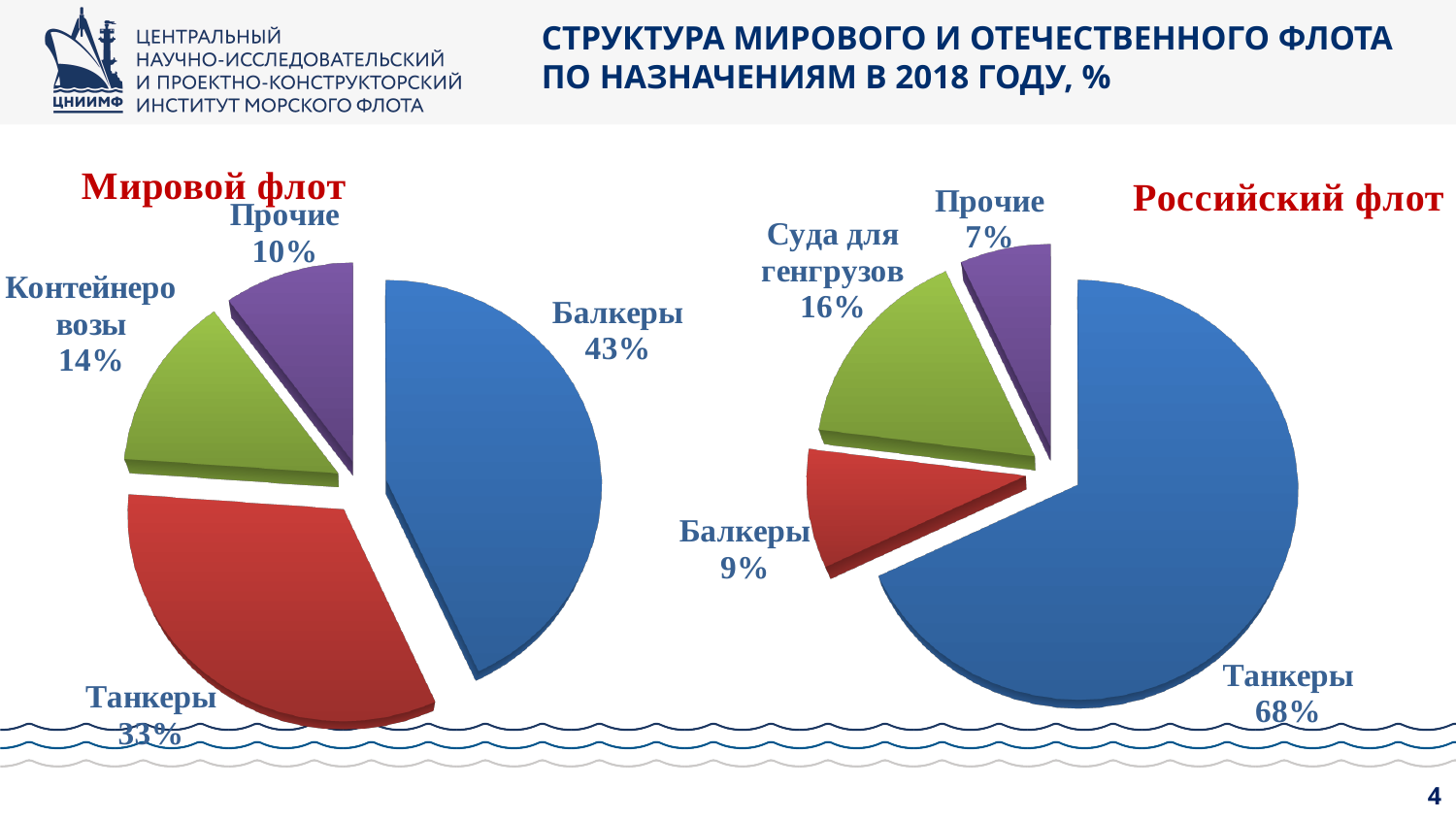
Which is larger: the share of Прочие in the 'Мировой флот' chart or the share of Прочие in the 'Российский флот' chart? Мировой флот In the 'Российский флот' pie chart, what share do Суда для генгрузов have? 16% In the 'Российский флот' pie chart, what share do Танкеры have? 68% In the 'Мировой флот' pie chart, what is the difference between the shares of Балкеры and Танкеры? 10% How many slices does the 'Российский флот' pie chart have? 4 In the 'Мировой флот' pie chart, what share do Контейнеровозы have? 14% How many pie charts are shown on the slide? 2 In the 'Мировой флот' pie chart, which category has the largest share? Балкеры In the 'Российский флот' pie chart, what is the difference between the shares of Танкеры and Балкеры? 59% In the 'Российский флот' pie chart, which category has the smallest share? Прочие What type of chart is used for 'Мировой флот'? Pie chart In the 'Мировой флот' pie chart, what share do Балкеры have? 43%